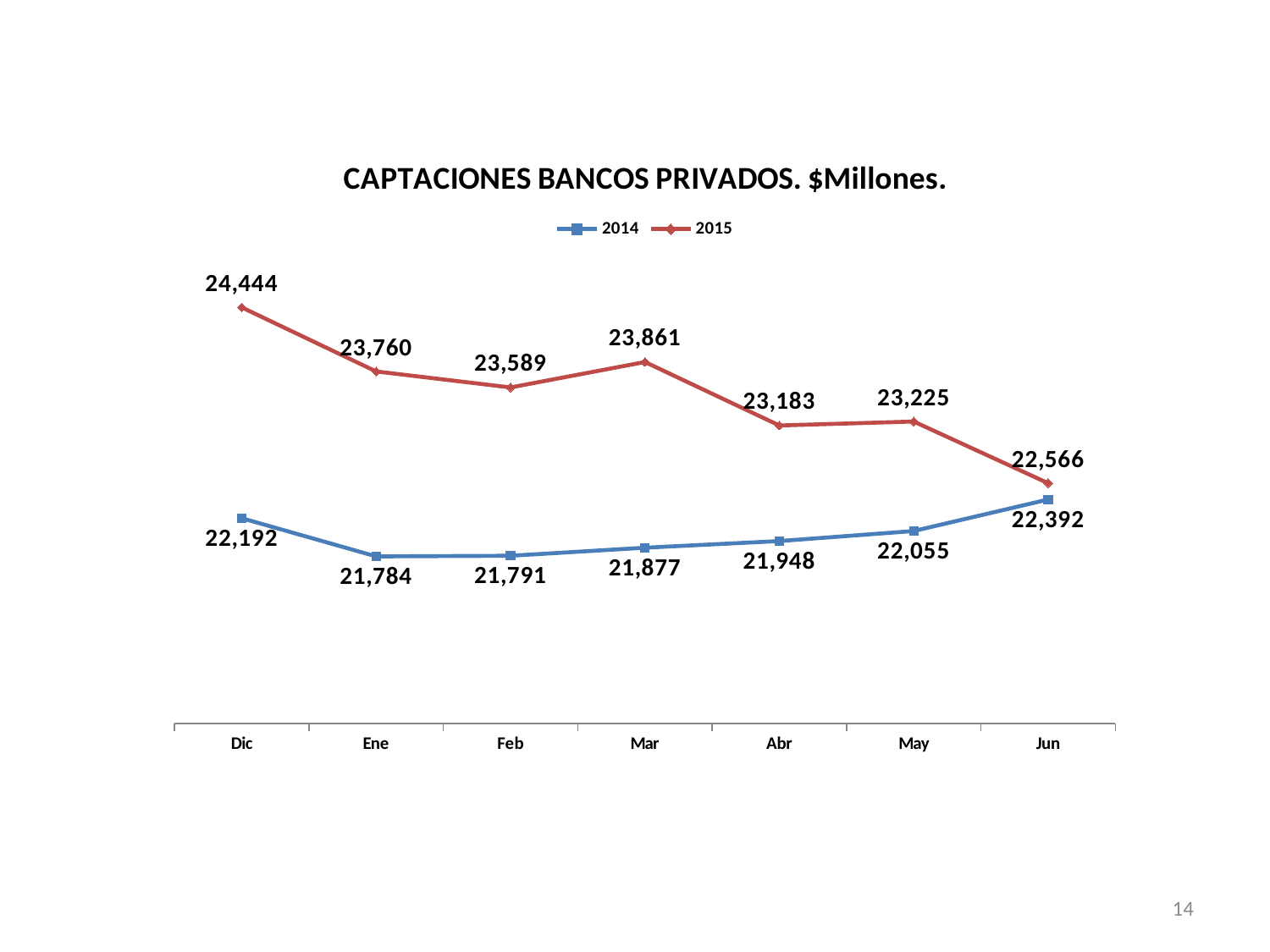
What is the difference between the 2015 and 2014 values in Dic? 2,252 What kind of chart is this? Line chart In which month is the 2015 series highest? Dic In which month is the 2015 series lowest? Jun What is the value for 2014 in Jun? 22,392 What is the value for 2014 in Ene? 21,784 What is the value for 2015 in Dic? 24,444 How many series does the legend list? 2 Which series has the larger value in Abr, 2014 or 2015? 2015 In which month is the 2014 series lowest? Ene How many months are shown on the x axis? 7 What is the value for 2015 in Mar? 23,861